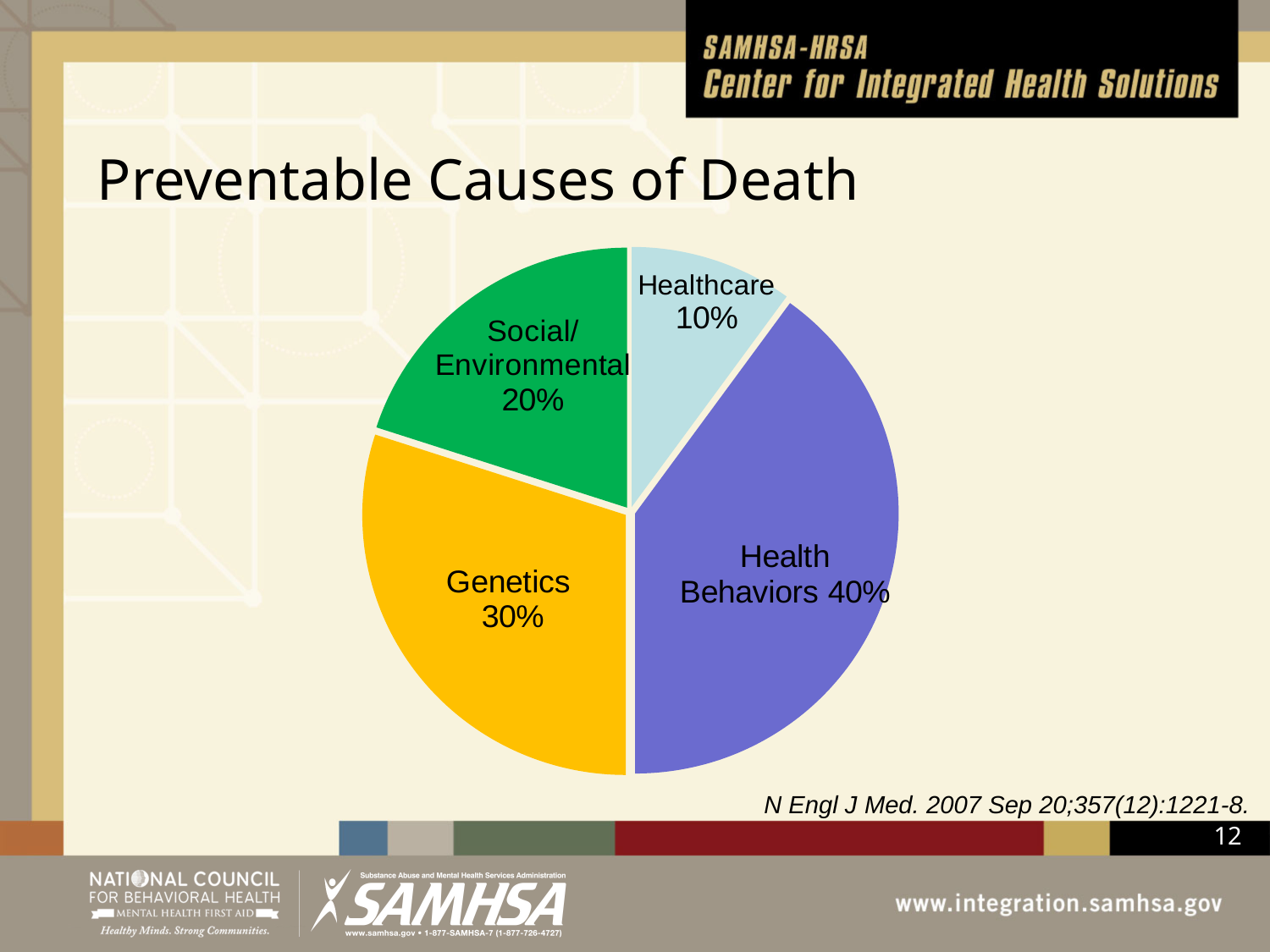
What percentage does the Health Behaviors slice represent? 40% Which is larger, the Genetics slice or the Social/Environmental slice? Genetics What percentage does the Healthcare slice represent? 10% What kind of chart is shown on the slide? pie chart How many slices does the pie chart have? 4 What percentage does the Social/Environmental slice represent? 20% Which slice of the pie is the smallest? Healthcare What is the combined share of the Genetics and Healthcare slices? 40% What percentage does the Genetics slice represent? 30% What is the title of the slide containing the pie chart? Preventable Causes of Death Which slice of the pie is the largest? Health Behaviors What is the difference between the Health Behaviors and Genetics percentages? 10%